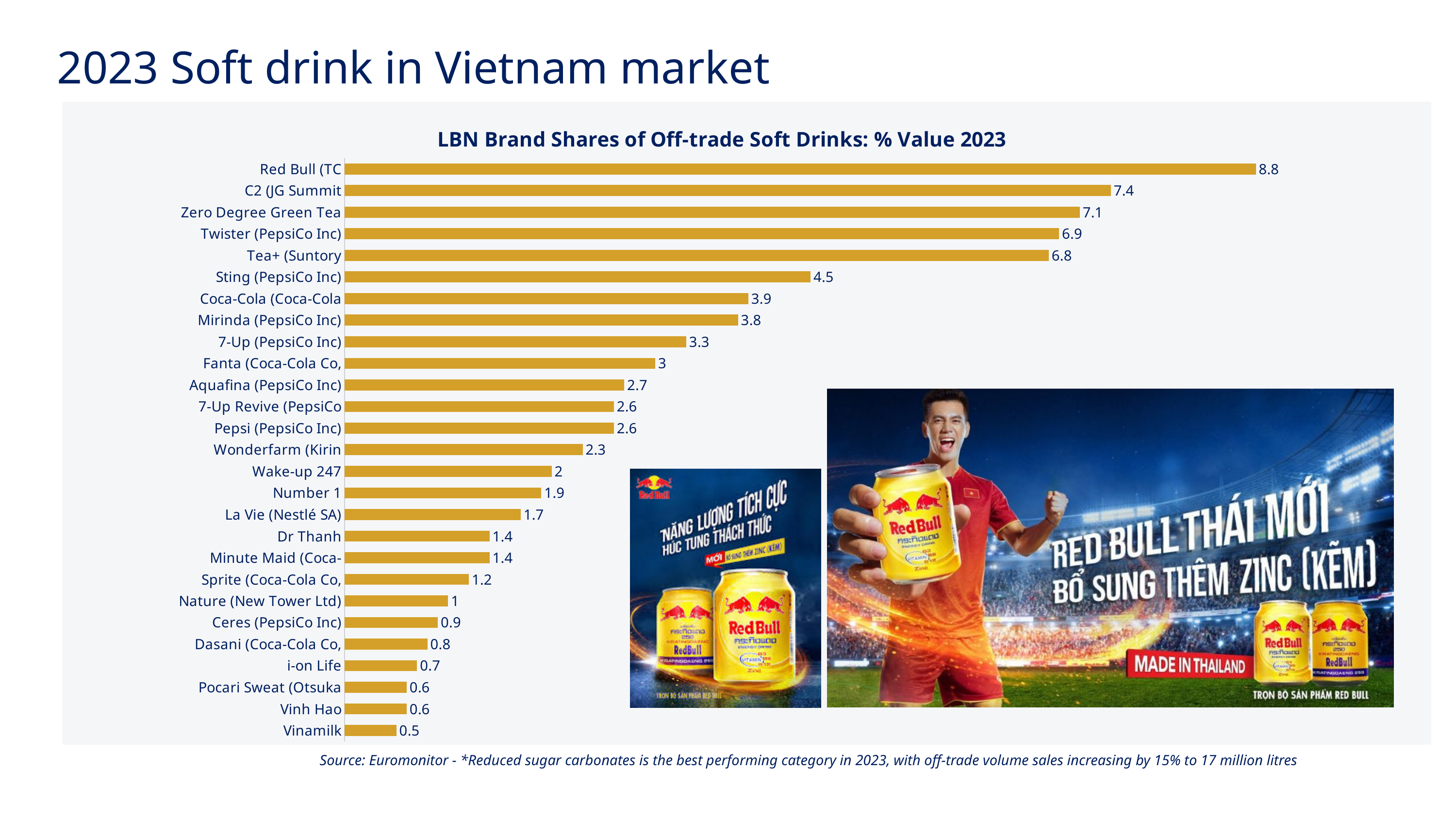
What is the value for Wonderfarm (Kirin) in the chart? 2.3 What kind of chart is shown on the slide? Bar chart What is the difference between the values for Coca-Cola (Coca-Cola and Pepsi (PepsiCo Inc)? 1.3 What is the difference between the values for Red Bull (TC and C2 (JG Summit? 1.4 What is the title of the chart? LBN Brand Shares of Off-trade Soft Drinks: % Value 2023 What is the value for La Vie (Nestlé SA) in the chart? 1.7 What is the value for Sting (PepsiCo Inc) in the LBN Brand Shares of Off-trade Soft Drinks chart? 4.5 Which brand has the lowest value in the chart? Vinamilk Which brand has the highest value in the chart? Red Bull (TC Which has a larger value, Sprite (Coca-Cola Co, or Dr Thanh? Dr Thanh How many brands are shown in the chart? 27 Which has a larger value, Twister (PepsiCo Inc) or Mirinda (PepsiCo Inc)? Twister (PepsiCo Inc)